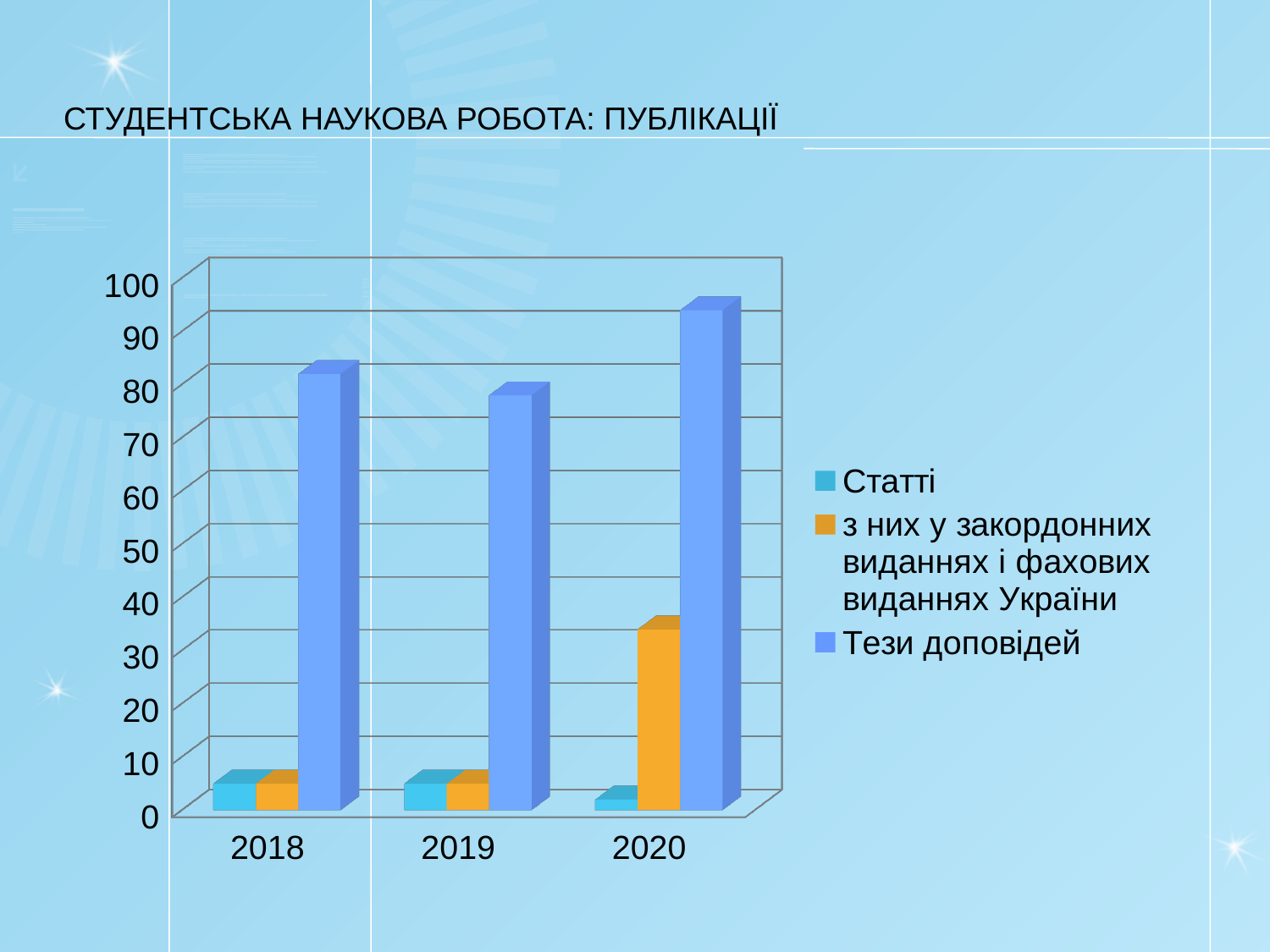
How many series does the chart legend list? 3 In which year is the value for Тези доповідей the highest? 2020 Is the value for Статті in 2018 greater or less than 10? less Which year has the larger value for з них у закордонних виданнях і фахових виданнях України, 2018 or 2020? 2020 What is the title of the slide containing the chart? СТУДЕНТСЬКА НАУКОВА РОБОТА: ПУБЛІКАЦІЇ Is the value for Тези доповідей in 2020 greater or less than 90? greater Is the value for з них у закордонних виданнях і фахових виданнях України in 2020 greater or less than 20? greater What kind of chart is shown on the slide? bar chart How many years are shown on the x axis of the chart? 3 In 2020, which series has the larger value, Статті or Тези доповідей? Тези доповідей